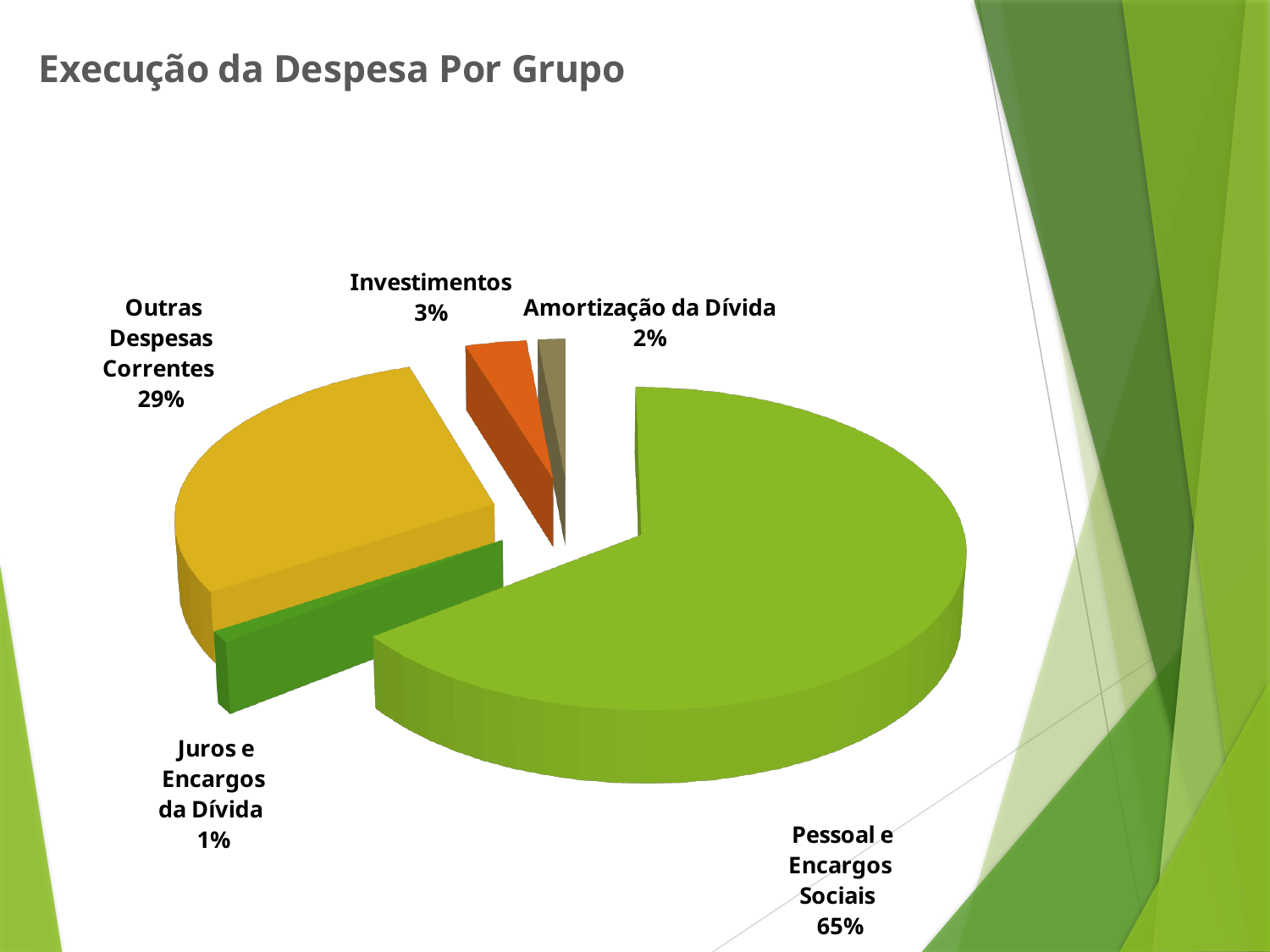
What is the title of the slide? Execução da Despesa Por Grupo How many categories are shown in the pie chart? 5 What share of the pie does Pessoal e Encargos Sociais represent? 65% Which category has the largest share of the pie? Pessoal e Encargos Sociais What is the value shown for Juros e Encargos da Dívida? 1% What is the difference in percentage points between Pessoal e Encargos Sociais and Outras Despesas Correntes? 36 percentage points Which category has the smallest share of the pie? Juros e Encargos da Dívida What share of the pie does Outras Despesas Correntes represent? 29% What kind of chart is shown on the slide? Pie chart What is the value shown for Investimentos? 3% Which is larger, Investimentos or Amortização da Dívida? Investimentos What is the value shown for Amortização da Dívida? 2%